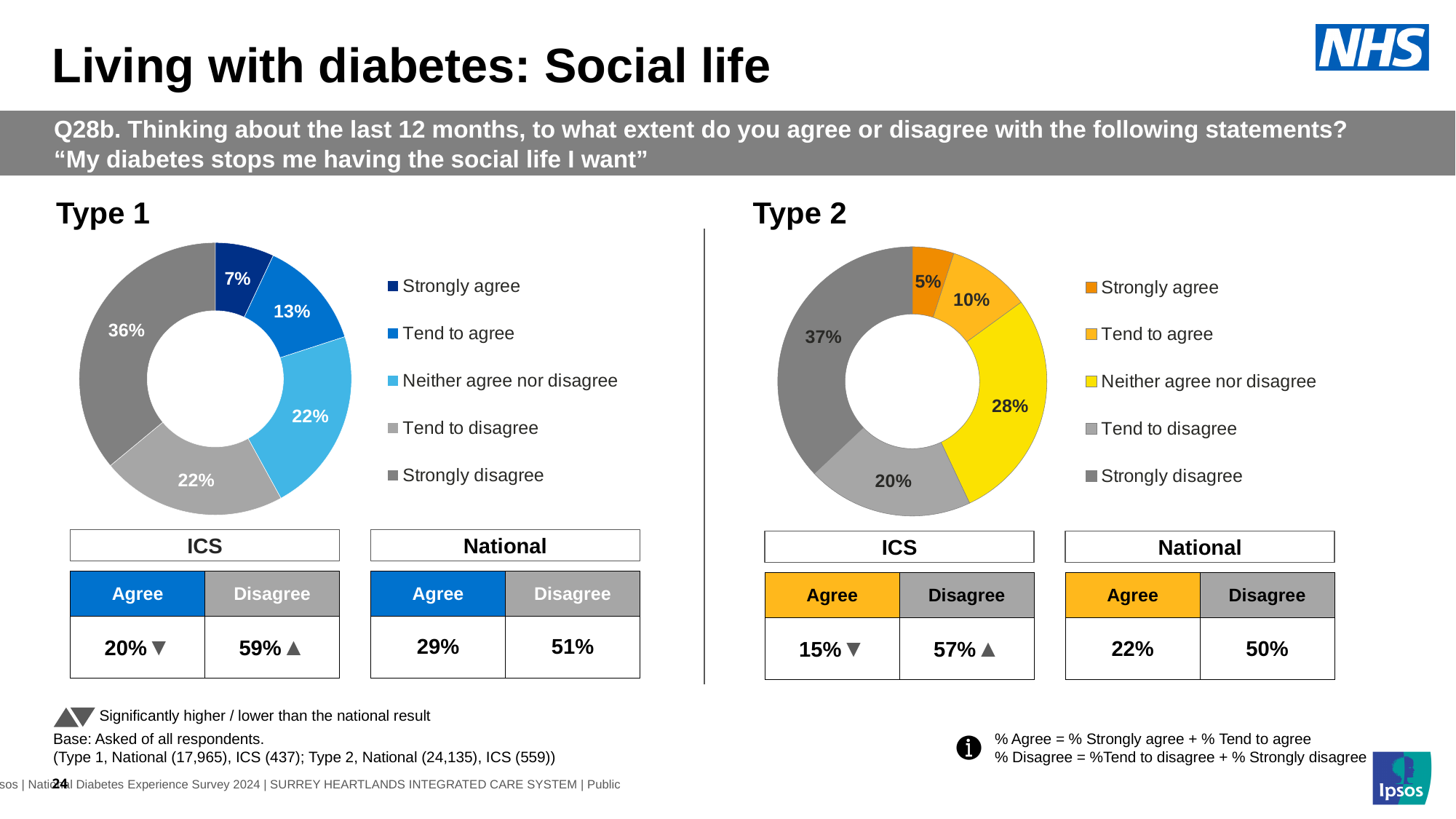
In the Type 2 chart, what percentage of respondents neither agree nor disagree? 28% What type of chart is used for Type 1? Donut chart In the Type 2 chart, what is the difference between the Strongly disagree share and the Tend to disagree share? 17% In the Type 1 chart, which is larger: Tend to agree or Neither agree nor disagree? Neither agree nor disagree In the Type 1 chart, what is the combined share of Strongly agree and Tend to agree? 20% What colour represents Strongly disagree in the Type 2 chart? Dark grey In the Type 1 chart, what percentage of respondents strongly agree? 7% In the Type 2 chart, what percentage of respondents tend to disagree? 20% How many entries does the legend of the Type 1 chart list? 5 How many categories does the Type 2 chart show? 5 In the Type 2 chart, which category has the smallest share? Strongly agree In the Type 1 chart, which category has the largest share? Strongly disagree